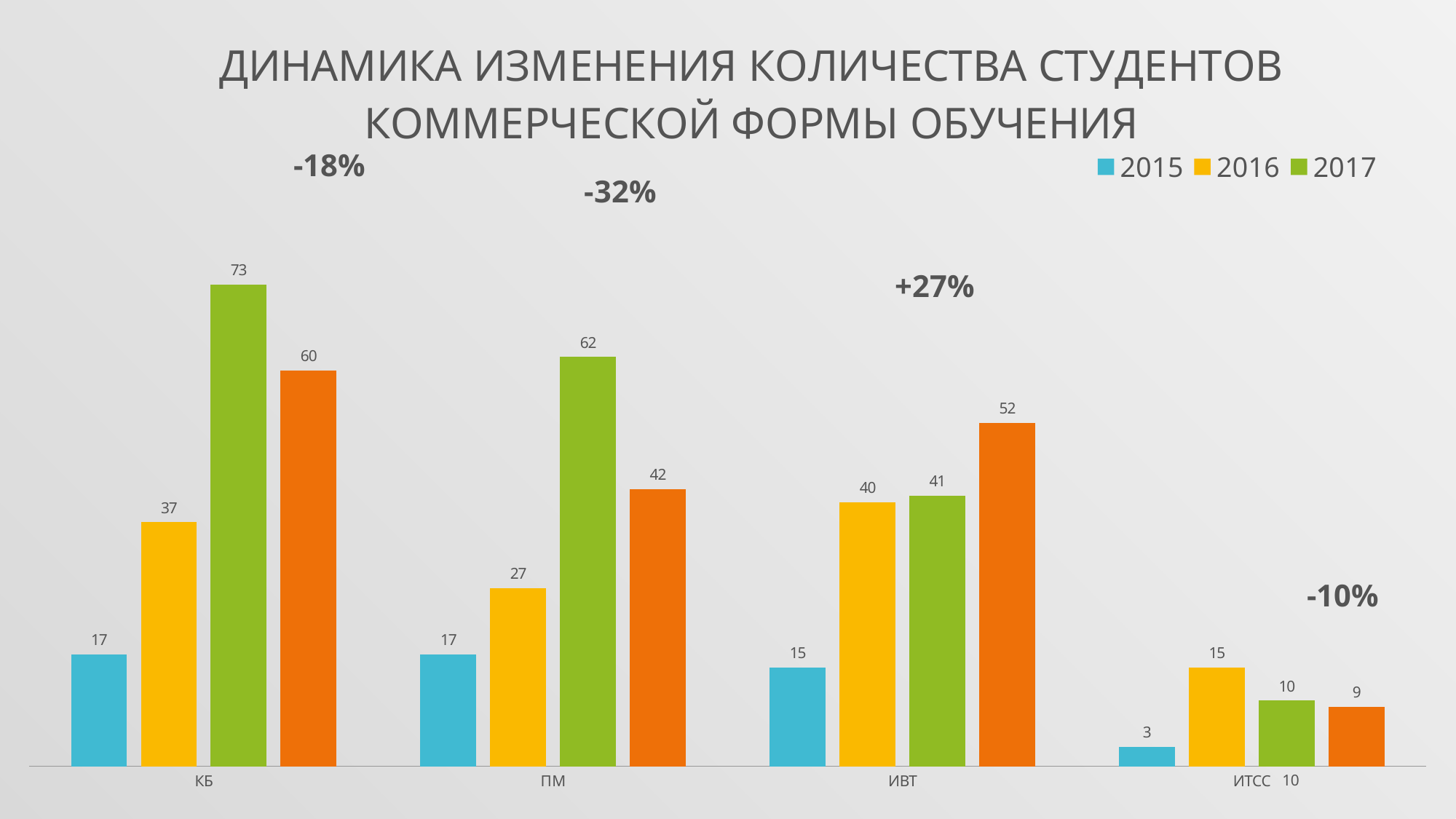
What is the difference between the 2017 and 2016 values in the КБ category? 36 Which category has the lowest value for 2016? ИТСС What is the value for 2016 in the ИВТ category? 40 What is the value for 2015 in the ИТСС category? 3 Which category has the highest value for 2017? КБ How many series does the chart's legend list? 3 Which is larger in the ПМ category: the 2017 value or the 2016 value? 2017 What is the value for 2016 in the ПМ category? 27 What percentage change is annotated above the ИВТ category? +27% How many categories are shown on the x axis of the chart? 4 What kind of chart is shown on the slide? bar chart What is the value for 2017 in the КБ category? 73